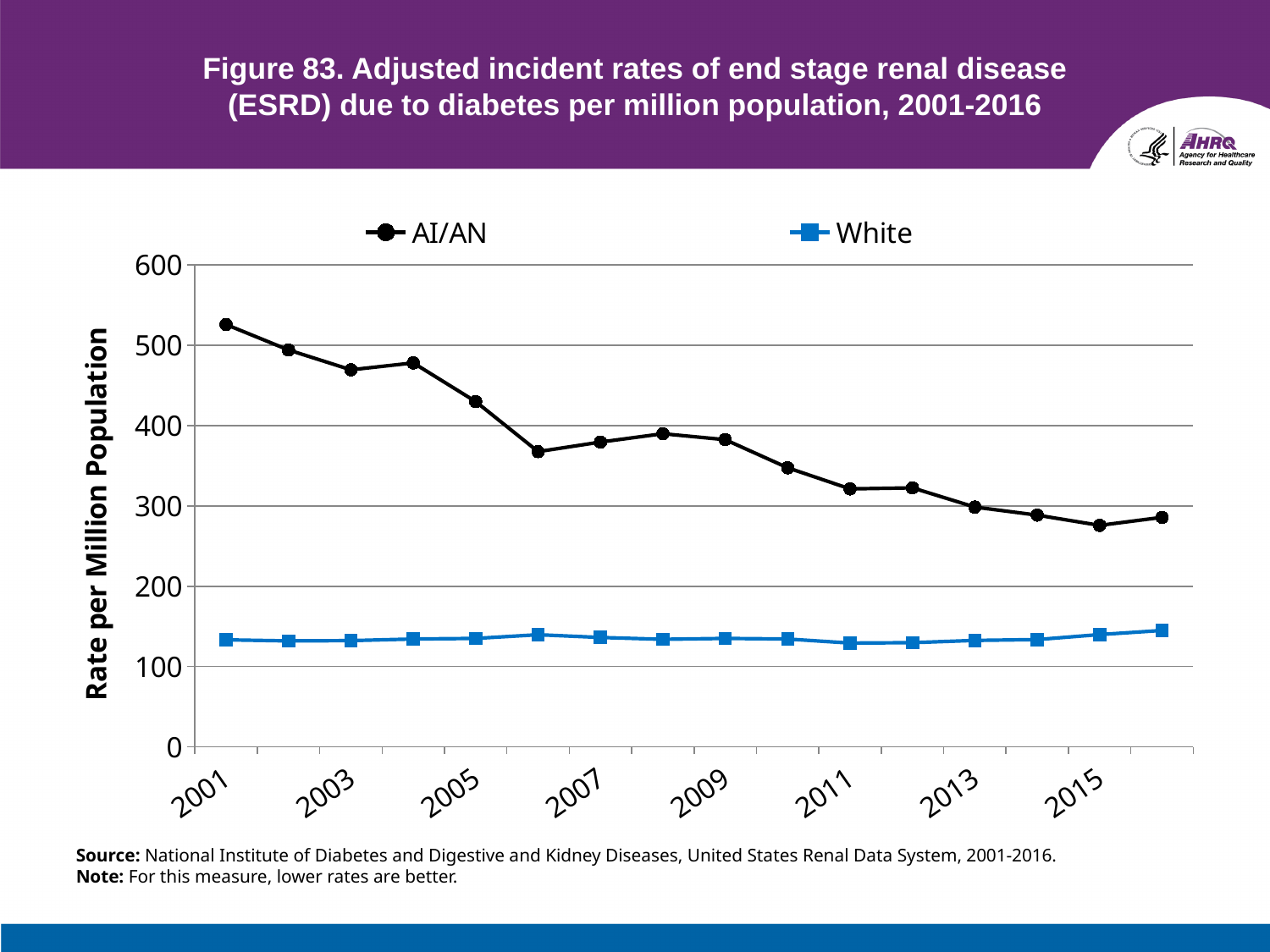
Does the AI/AN rate generally rise or fall from 2001 to 2016? fall Is the White value for 2016 greater or less than 200? less Is the AI/AN value for 2001 greater or less than 500? greater What kind of chart is shown on the slide? line chart Is the AI/AN value for 2006 greater or less than 400? less How many years of data are plotted for each series? 16 Which year has the highest AI/AN rate? 2001 In 2009, which group has the higher rate, AI/AN or White? AI/AN What is the label on the vertical axis? Rate per Million Population Which year has the lowest AI/AN rate? 2015 How many series does the legend list? 2